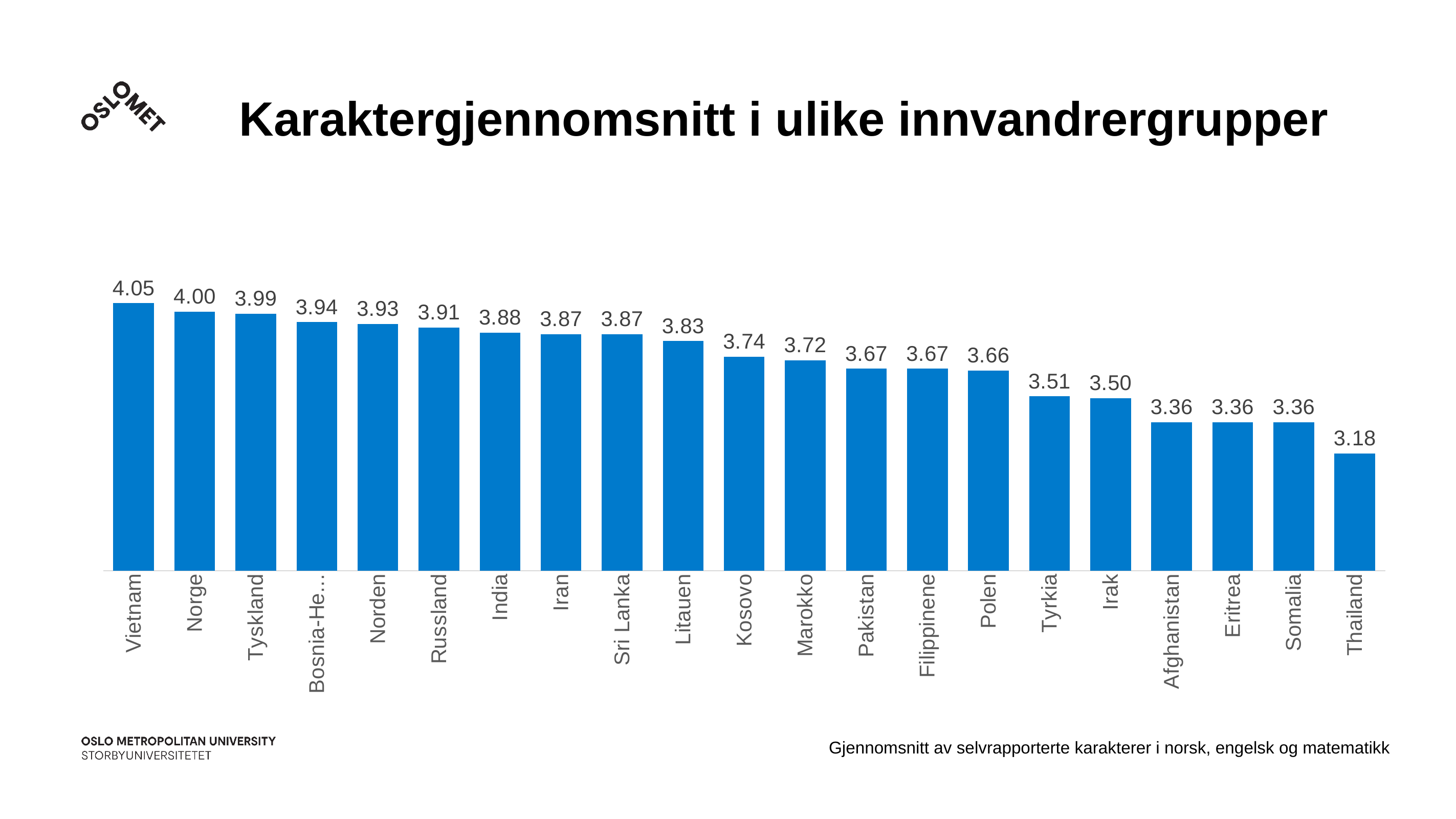
What kind of chart is shown on the slide? Bar chart Which is larger, the value for Kosovo or the value for Tyrkia? Kosovo What is the value for Sri Lanka? 3.87 What is the value for Vietnam? 4.05 What is the difference between the values for Norge and Polen? 0.34 Which group has the lowest value? Thailand Do the values rise or fall from left to right along the x axis? Fall What is the value for Irak? 3.50 What is the difference between the values for Vietnam and Thailand? 0.87 Which group has the highest value? Vietnam How many groups are shown in the chart? 21 What is the value for Polen? 3.66